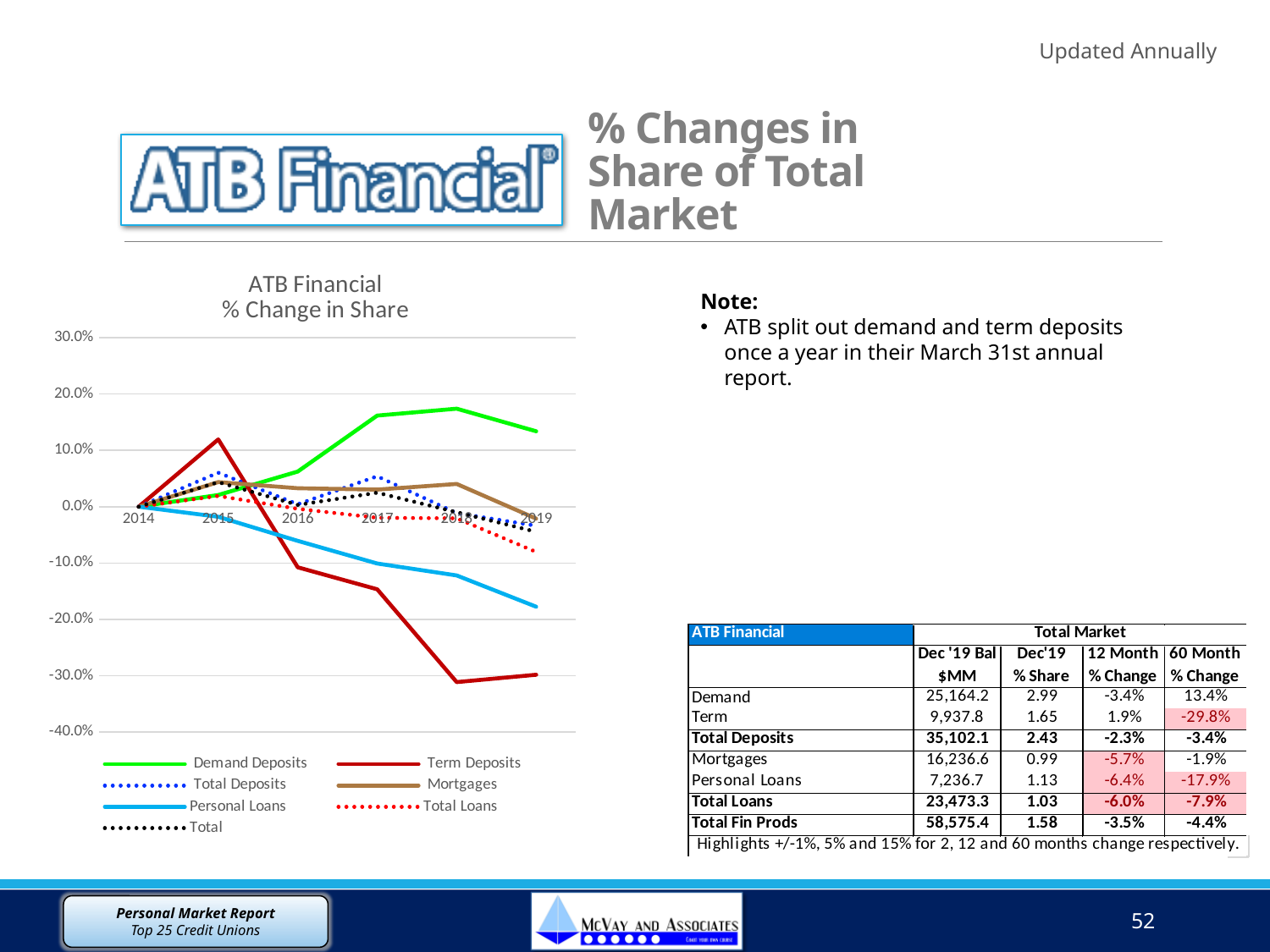
What kind of chart is shown on the slide? line chart Which series has the lowest value in 2019? Term Deposits Is the value for Personal Loans in 2019 greater or less than -10.0%? less Which series has the highest value in 2015? Term Deposits Is the value for Demand Deposits in 2018 greater or less than 10.0%? greater How many series does the legend of the chart list? 7 Is the value for Term Deposits in 2018 greater or less than -20.0%? less In 2017, which is larger: Demand Deposits or Mortgages? Demand Deposits Does the Personal Loans line rise or fall from 2014 to 2019? fall How many years are plotted along the x axis of the chart? 6 Which series has the highest value in 2019? Demand Deposits What is the title of the chart? ATB Financial % Change in Share